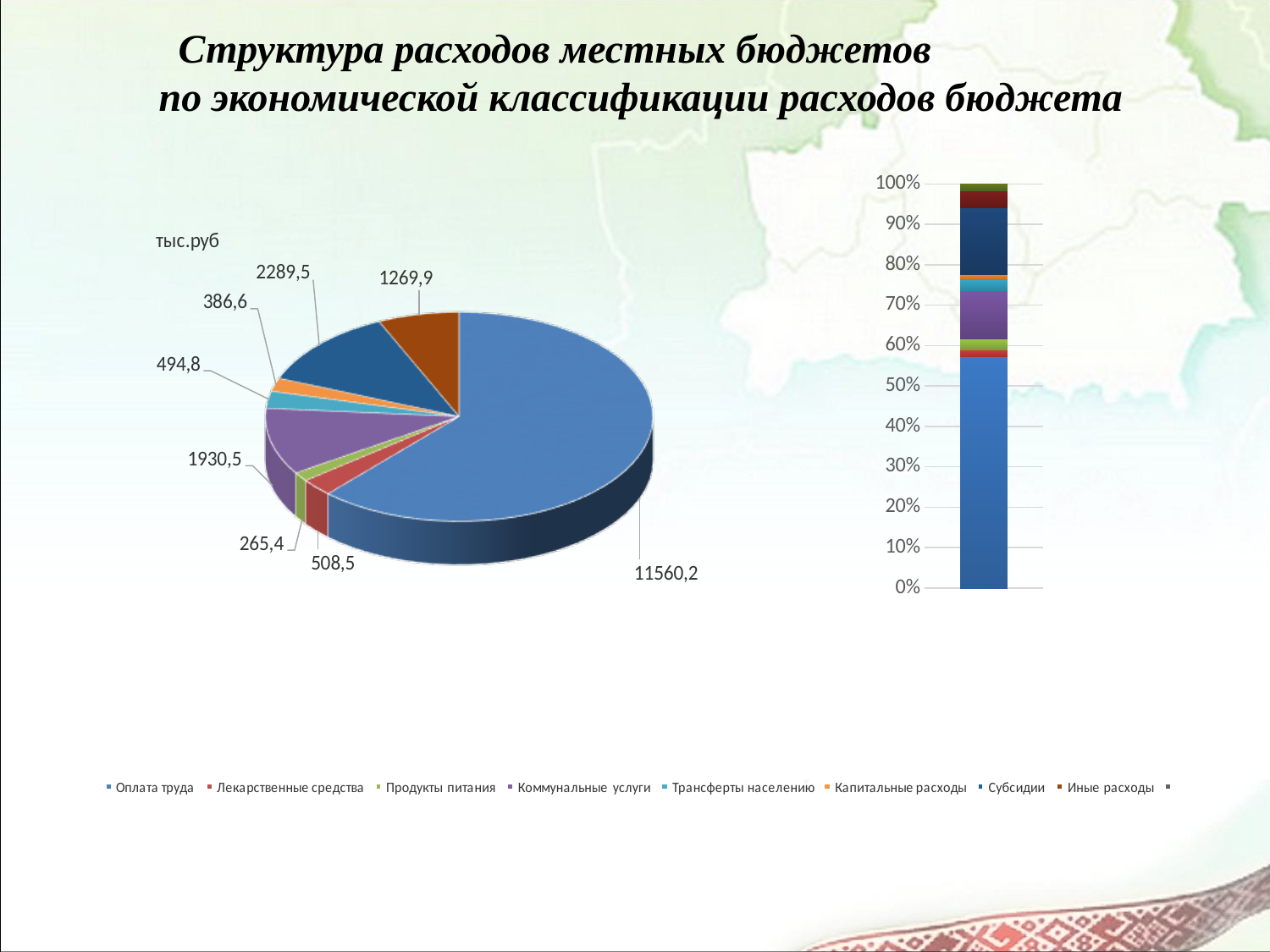
In the pie chart, what is the value for Продукты питания? 265,4 In the pie chart, which category has the largest value? Оплата труда In the pie chart, what is the difference between the values for Субсидии and Коммунальные услуги? 359,0 In the pie chart, which is larger: Лекарственные средства or Трансферты населению? Лекарственные средства How many data labels are shown on the pie chart? 8 In the pie chart, what is the value for Капитальные расходы? 386,6 In the pie chart, which category has the smallest value? Продукты питания In the pie chart, what is the value for Оплата труда? 11560,2 In the stacked bar chart on the right, is the share of Оплата труда greater or less than 50%? greater In the pie chart, what is the value for Коммунальные услуги? 1930,5 What unit is indicated for the values in the pie chart? тыс.руб In the pie chart, what is the value for Субсидии? 2289,5